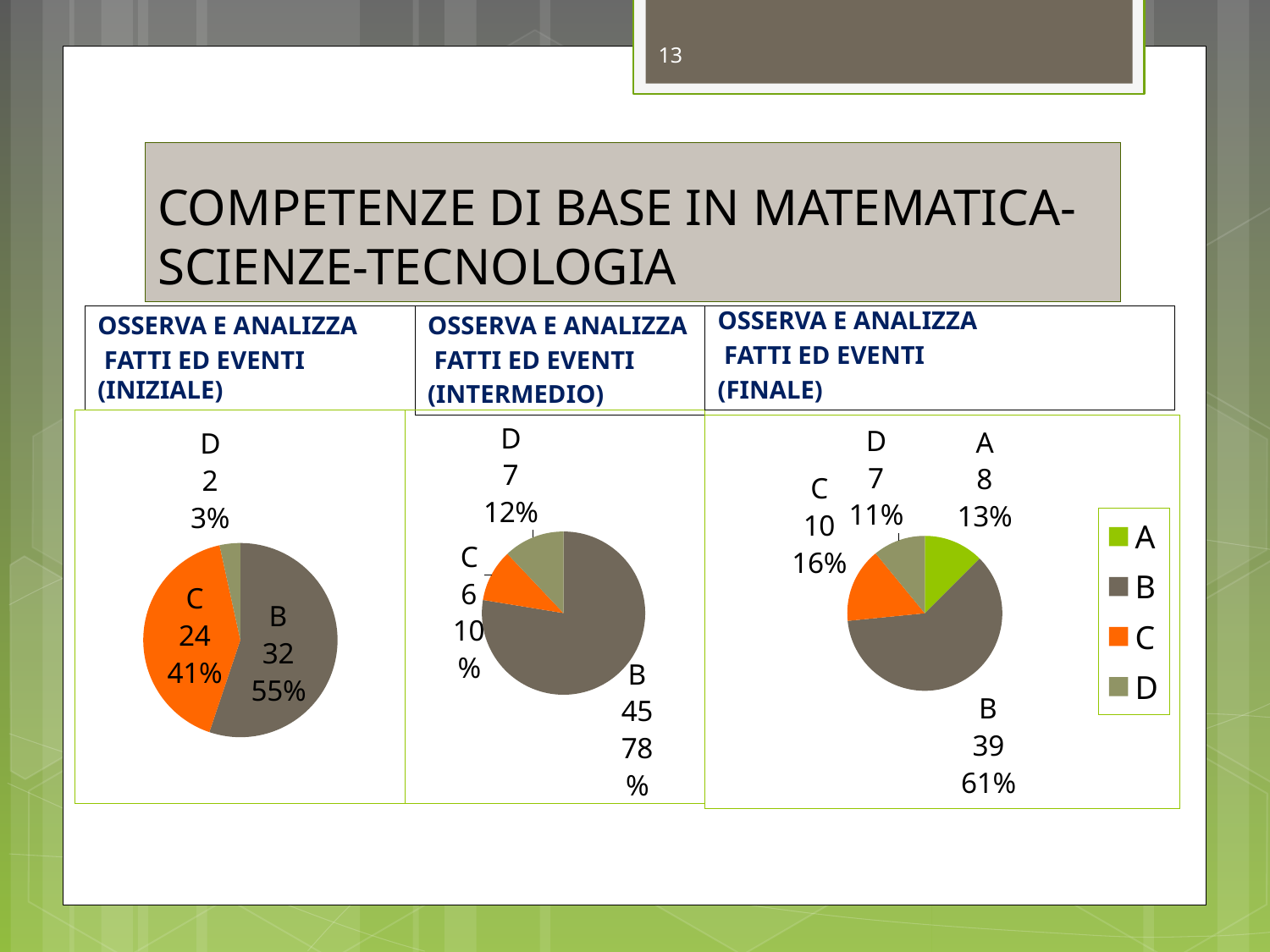
In the INIZIALE pie chart, which category is the smallest? D In the FINALE pie chart, what is the difference between the values for category B and category C? 29 In the INTERMEDIO pie chart, which is larger, category C or category D? D In the FINALE pie chart, which category is the largest? B In the FINALE pie chart, what is the value for category A? 8 In the INTERMEDIO pie chart, what is the value for category B? 45 In the INIZIALE pie chart, what share of the pie does category C have? 41% How many entries does the legend on the right of the slide list? 4 In the INIZIALE pie chart, what is the value for category B? 32 How many categories are shown in the FINALE pie chart? 4 What kind of chart is used for the INIZIALE data? Pie chart In the INTERMEDIO pie chart, what share of the pie does category D have? 12%